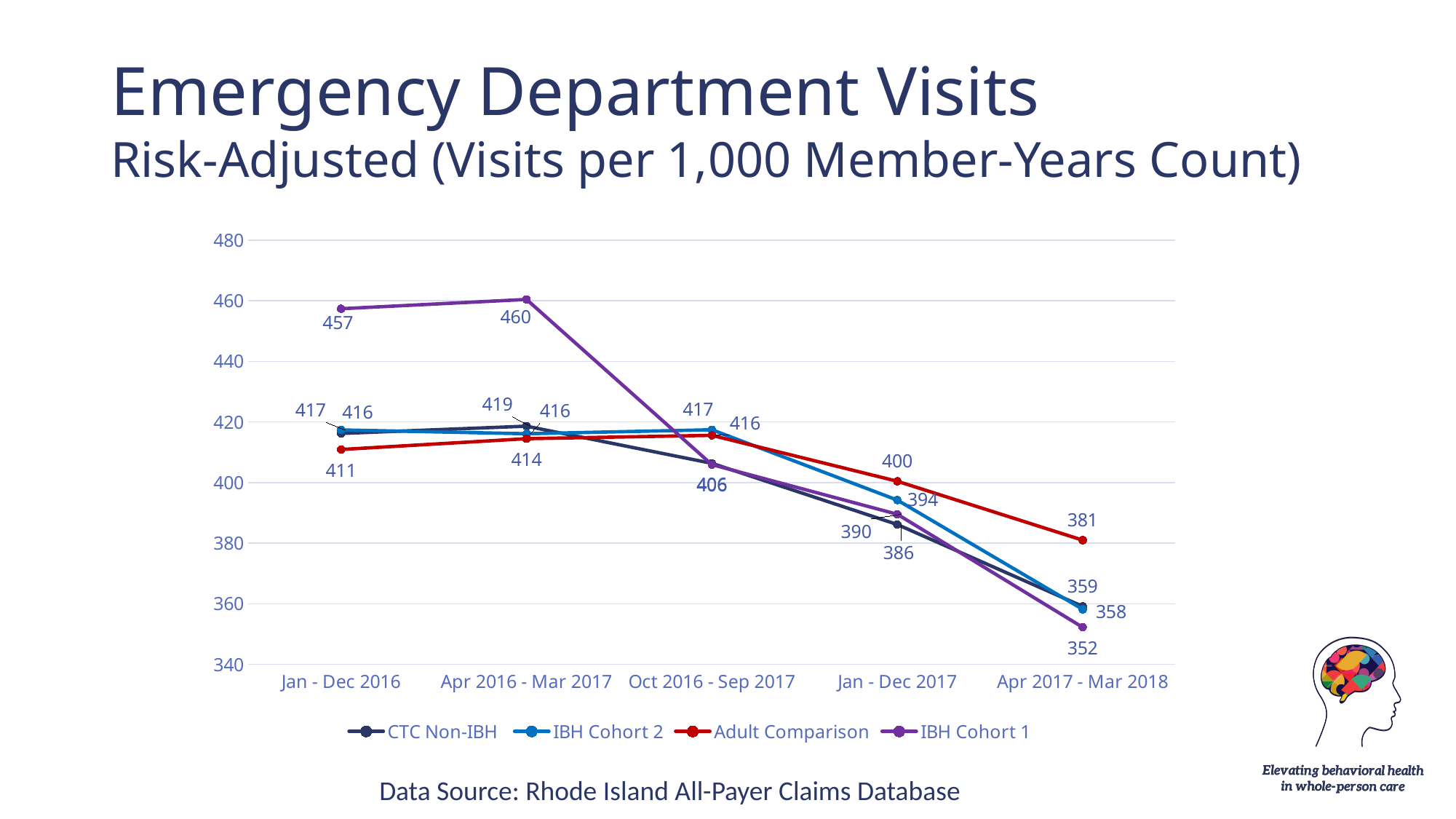
How many series does the legend list? 4 What is the value for Adult Comparison in Apr 2017 - Mar 2018? 381 What is the difference between Adult Comparison and IBH Cohort 1 in Apr 2017 - Mar 2018? 29 How many time periods are shown on the x axis? 5 Does the IBH Cohort 1 line rise or fall from Apr 2016 - Mar 2017 to Apr 2017 - Mar 2018? Fall In which period does IBH Cohort 1 reach its highest value? Apr 2016 - Mar 2017 What is the value for CTC Non-IBH in Jan - Dec 2017? 386 Is the value for IBH Cohort 1 in Jan - Dec 2016 greater or less than 440? greater In Jan - Dec 2017, which is larger: Adult Comparison or IBH Cohort 2? Adult Comparison What is the value for IBH Cohort 1 in Apr 2016 - Mar 2017? 460 What type of chart is shown on the slide? Line chart Which series has the lowest value in Apr 2017 - Mar 2018? IBH Cohort 1